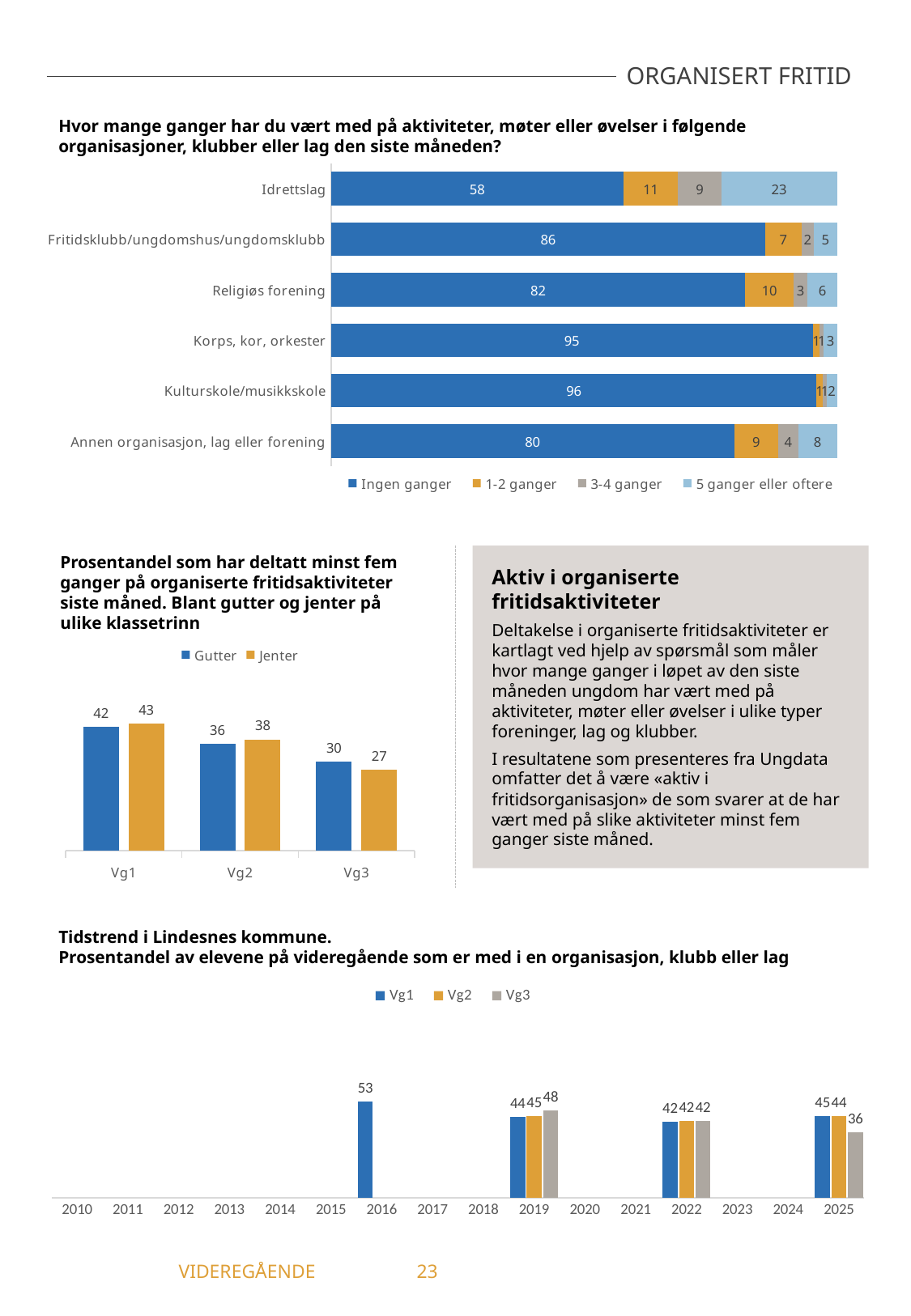
In the middle-left chart (Prosentandel som har deltatt minst fem ganger...), do the Gutter values rise or fall from Vg1 to Vg3? fall In the middle-left chart (Prosentandel som har deltatt minst fem ganger...), which is larger at Vg3, Gutter or Jenter? Gutter In the top chart (Hvor mange ganger har du vært med på aktiviteter...), how many categories are shown? 6 In the top chart (Hvor mange ganger har du vært med på aktiviteter...), which category has the highest value for 'Ingen ganger'? Kulturskole/musikkskole What kind of chart is the bottom chart (Tidstrend i Lindesnes kommune)? bar chart In the top chart (Hvor mange ganger har du vært med på aktiviteter...), what is the value for '5 ganger eller oftere' for Idrettslag? 23 In the bottom chart (Tidstrend i Lindesnes kommune), what is the difference between the Vg1 values in 2016 and 2025? 8 In the top chart (Hvor mange ganger har du vært med på aktiviteter...), how many series does the legend list? 4 In the top chart (Hvor mange ganger har du vært med på aktiviteter...), what is the value for 'Ingen ganger' for Idrettslag? 58 In the middle-left chart (Prosentandel som har deltatt minst fem ganger...), what is the value for Jenter at Vg2? 38 In the bottom chart (Tidstrend i Lindesnes kommune), what is the value for Vg3 in 2019? 48 In the top chart (Hvor mange ganger har du vært med på aktiviteter...), what is the difference between the 'Ingen ganger' values for Fritidsklubb/ungdomshus/ungdomsklubb and Religiøs forening? 4